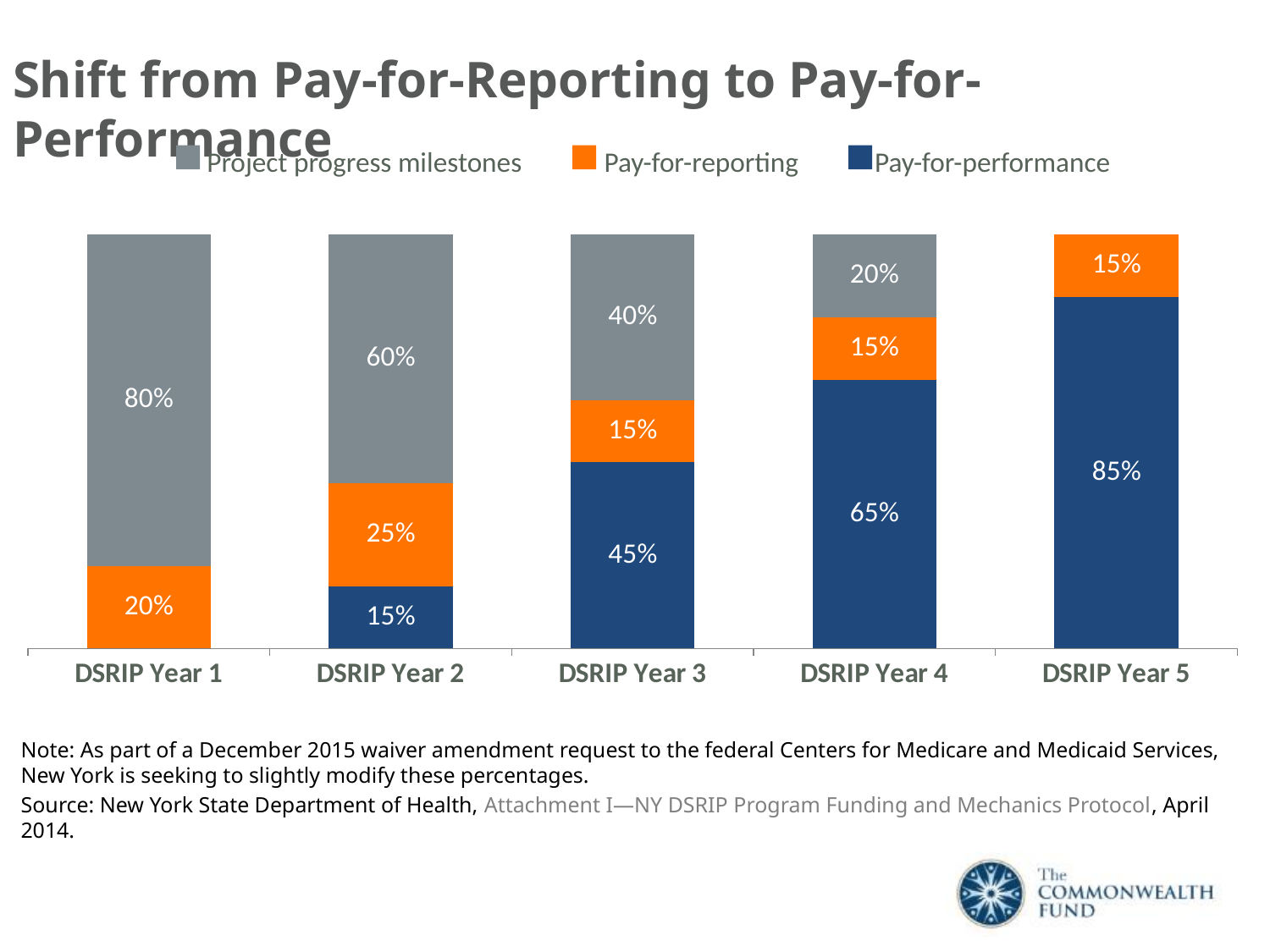
Does the Pay-for-performance value rise or fall from DSRIP Year 2 to DSRIP Year 5? Rise Which year has the lowest Project progress milestones value among years where it is shown? DSRIP Year 4 What is the difference between the Pay-for-performance values for DSRIP Year 4 and DSRIP Year 3? 20% How many years are shown on the x axis? 5 Which is larger: the Pay-for-reporting value for DSRIP Year 2 or for DSRIP Year 1? DSRIP Year 2 How many series does the legend list? 3 What is the Pay-for-performance value for DSRIP Year 3? 45% What is the Pay-for-reporting value for DSRIP Year 2? 25% What is the Pay-for-performance value for DSRIP Year 5? 85% Which year has the highest Pay-for-performance value? DSRIP Year 5 What is the Project progress milestones value for DSRIP Year 1? 80% What kind of chart is shown on the slide? Stacked bar chart